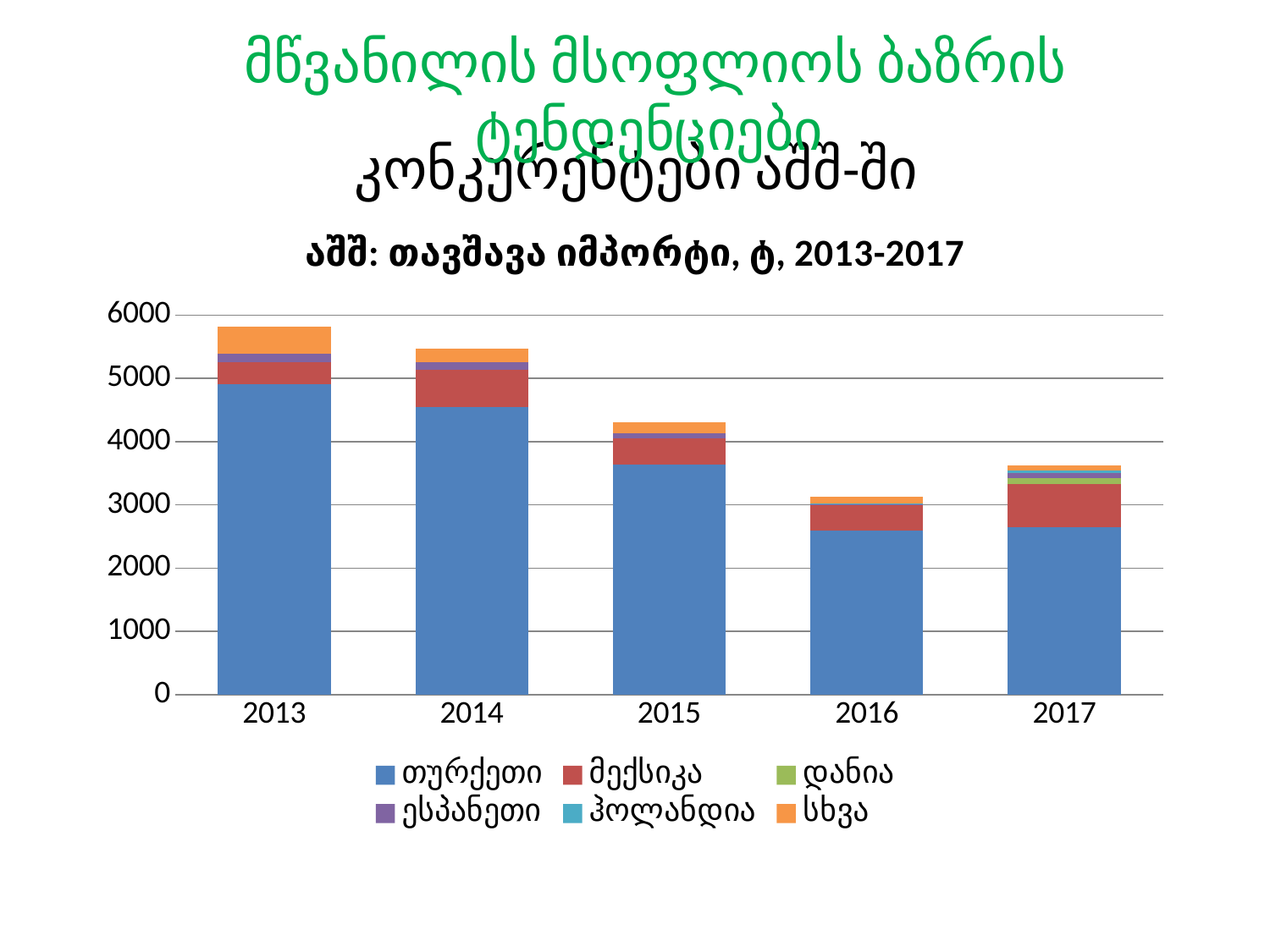
Which series is shown in blue in the chart legend? თურქეთი How many series does the chart legend list? 6 What kind of chart is shown on the slide? stacked bar chart Is the total bar for 2017 greater or less than 4000? less Which year has the highest total stacked bar? 2013 Is the total bar for 2015 greater or less than 4000? greater Do the total bars rise or fall from 2013 to 2016? fall Is the თურქეთი (Turkey) segment for 2016 greater or less than 3000? less Which is larger, the total bar for 2013 or the total bar for 2017? 2013 Which year has the lowest total stacked bar? 2016 How many years are shown on the x axis of the chart? 5